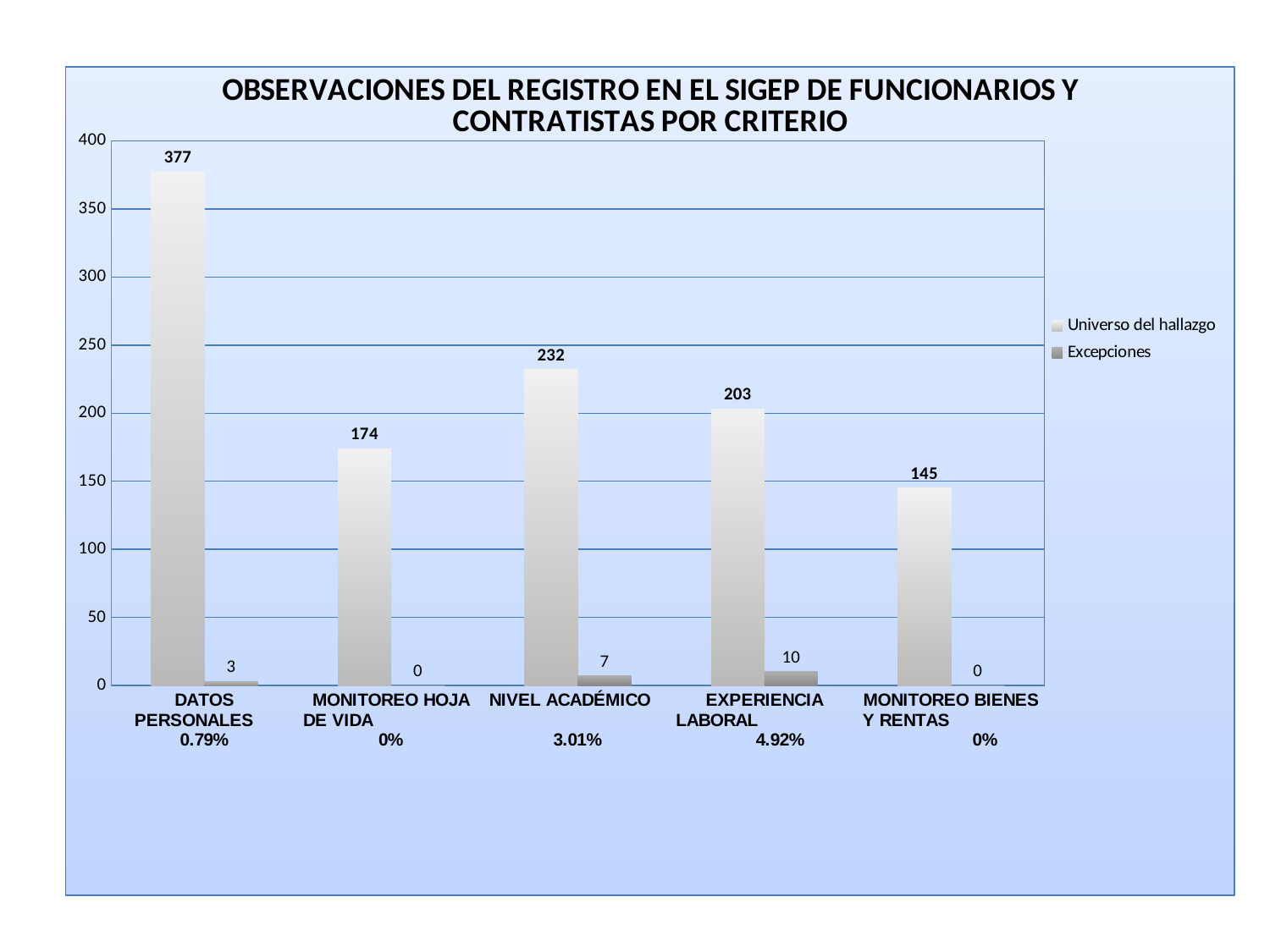
How many series does the legend list? 2 Which category has the lowest Universo del hallazgo value? MONITOREO BIENES Y RENTAS What is the value of Universo del hallazgo for MONITOREO BIENES Y RENTAS? 145 Which is larger, the Universo del hallazgo value for MONITOREO HOJA DE VIDA or for MONITOREO BIENES Y RENTAS? MONITOREO HOJA DE VIDA Which category has the highest Universo del hallazgo value? DATOS PERSONALES What is the difference between the Universo del hallazgo values for NIVEL ACADÉMICO and EXPERIENCIA LABORAL? 29 What are the two series listed in the legend? Universo del hallazgo and Excepciones How many categories are shown on the x axis? 5 What is the Excepciones value for NIVEL ACADÉMICO? 7 What kind of chart is shown on the slide? Bar chart What is the value of Excepciones for EXPERIENCIA LABORAL? 10 What is the value of Universo del hallazgo for DATOS PERSONALES? 377